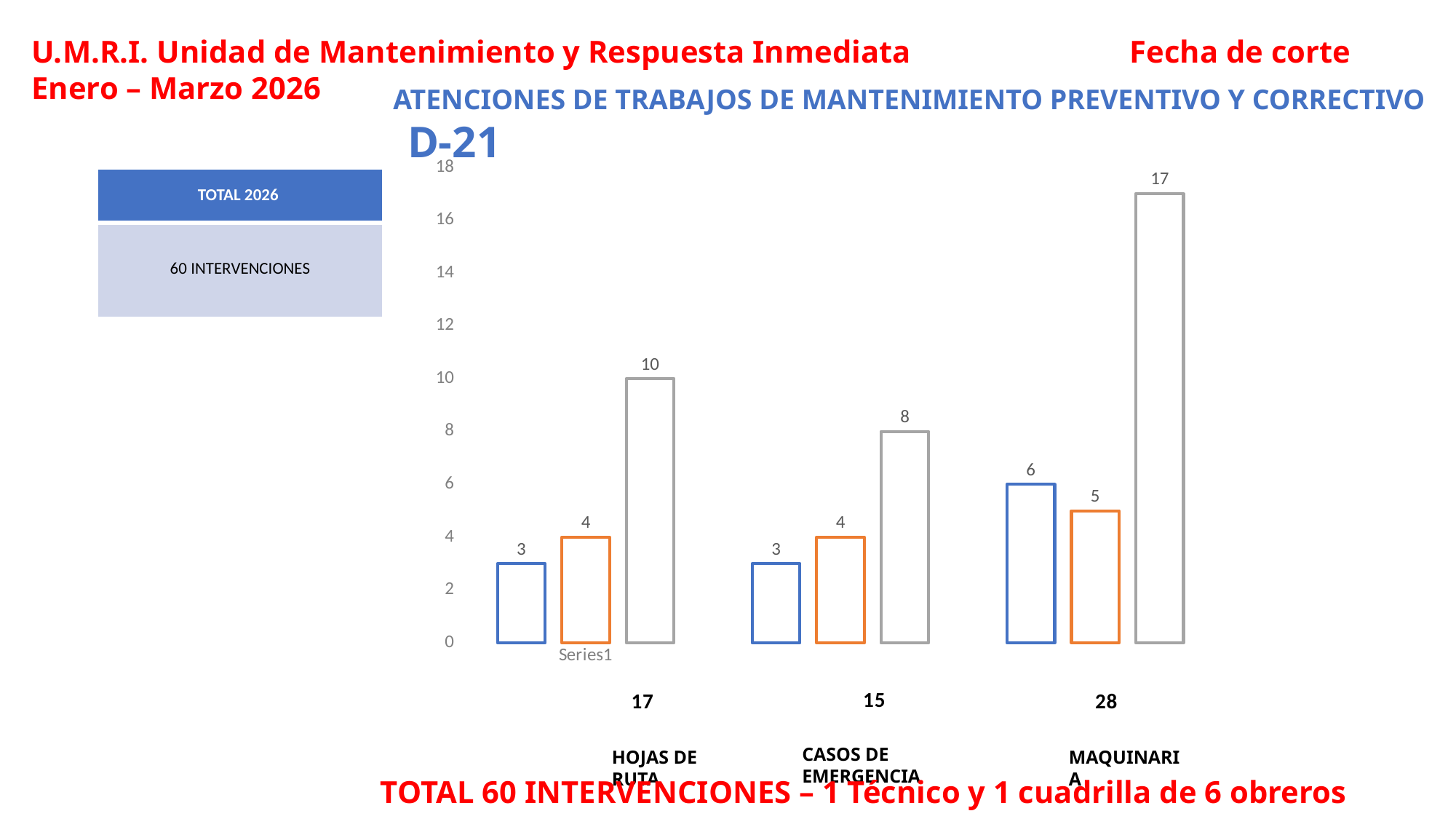
What total is printed below the CASOS DE EMERGENCIA group? 15 Which category has the lowest gray bar? CASOS DE EMERGENCIA Which is larger for MAQUINARIA, the blue bar or the orange bar? the blue bar What type of chart is shown on the slide? bar chart How many category groups are shown along the x axis of the chart? 3 What is the value of the orange bar for CASOS DE EMERGENCIA? 4 What is the value of the blue bar for HOJAS DE RUTA? 3 What is the value of the gray bar for CASOS DE EMERGENCIA? 8 What is the difference between the gray bar for MAQUINARIA and the gray bar for HOJAS DE RUTA? 7 Which category has the highest gray bar? MAQUINARIA What is the title of the chart? ATENCIONES DE TRABAJOS DE MANTENIMIENTO PREVENTIVO Y CORRECTIVO D-21 What is the value of the gray bar for MAQUINARIA? 17